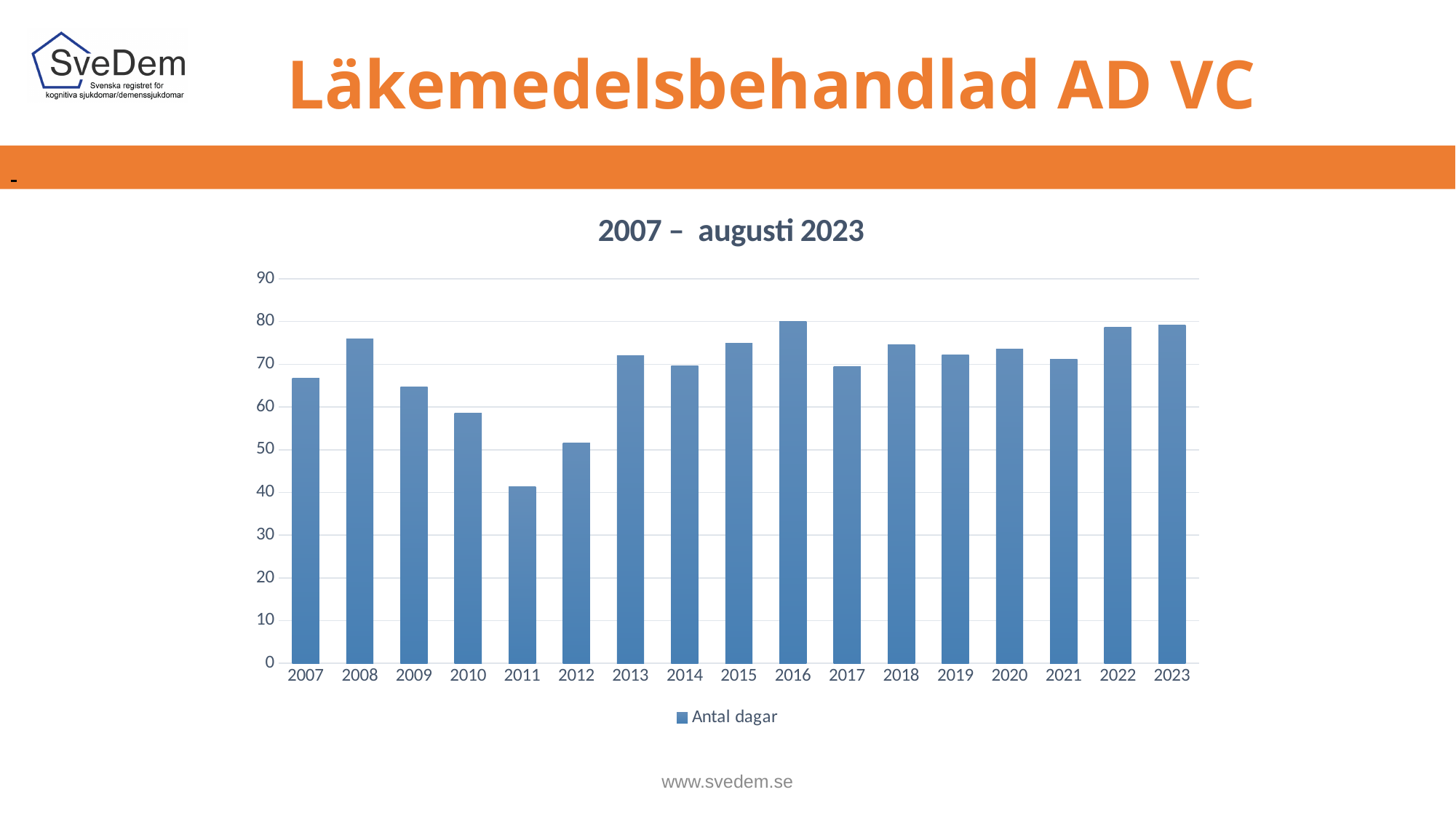
How many years are shown on the x axis of the chart? 17 What kind of chart is shown on the slide? bar chart Is the value for 2009 greater or less than 60? greater What is the title shown above the chart? 2007 – augusti 2023 Do the values rise or fall from 2008 to 2011? fall Is the value for 2007 greater or less than 70? less Is the value for 2016 greater or less than 70? greater How many series does the chart's legend list? 1 What is the legend entry for the series in the chart? Antal dagar Which year has the lowest value in the chart? 2011 Which is larger, the value for 2008 or the value for 2009? 2008